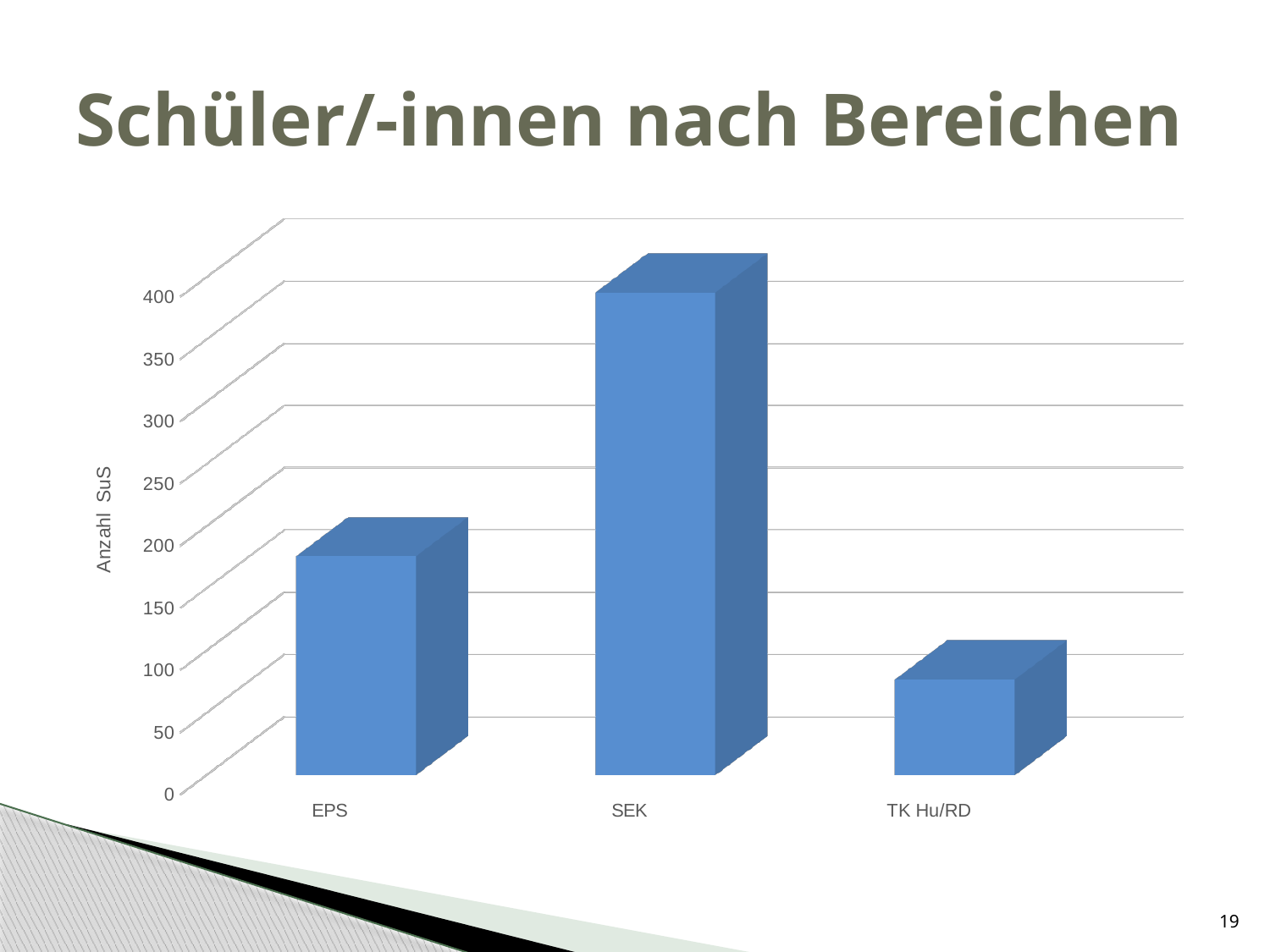
Which is larger, the value for EPS or the value for TK Hu/RD? EPS What is the title of the chart? Schüler/-innen nach Bereichen Which is larger, the value for SEK or the value for EPS? SEK Which category has the highest value? SEK Is the value for EPS greater or less than 150? greater What is the label of the vertical axis? Anzahl SuS What kind of chart is shown on the slide? bar chart Is the value for EPS greater or less than 250? less Which category has the lowest value? TK Hu/RD Is the value for TK Hu/RD greater or less than 150? less How many categories are shown on the x axis? 3